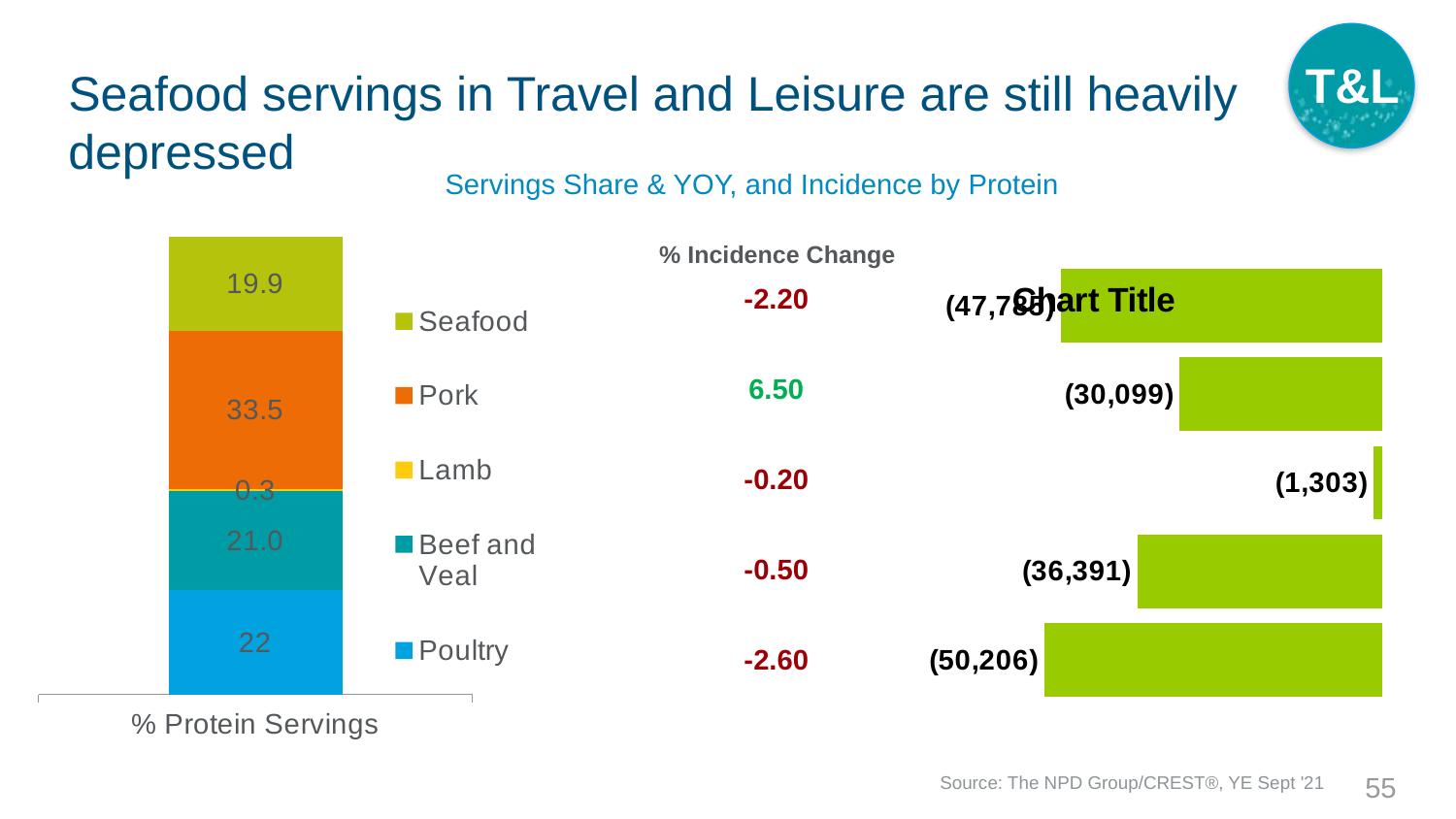
In the stacked bar chart on the left (% Protein Servings), which protein has the largest share of servings? Pork How many series does the legend of the stacked bar chart on the left list? 5 In the horizontal bar chart on the right, what is the value shown on the bar for Poultry (the bottom bar)? (50,206) What kind of chart is the chart on the left labelled % Protein Servings? Stacked bar chart In the stacked bar chart on the left (% Protein Servings), which protein has the smallest share of servings? Lamb In the stacked bar chart on the left (% Protein Servings), what is the value for Seafood? 19.9 In the stacked bar chart on the left (% Protein Servings), what is the value for Lamb? 0.3 In the horizontal bar chart on the right, what is the value shown on the bar for Beef and Veal (the fourth bar from the top)? (36,391) In the stacked bar chart on the left (% Protein Servings), what is the value for Pork? 33.5 In the horizontal bar chart on the right, what is the value shown on the bar for Lamb (the middle bar)? (1,303) In the stacked bar chart on the left (% Protein Servings), which is larger, the value for Poultry or the value for Beef and Veal? Poultry In the stacked bar chart on the left (% Protein Servings), what is the difference between the Pork value and the Seafood value? 13.6